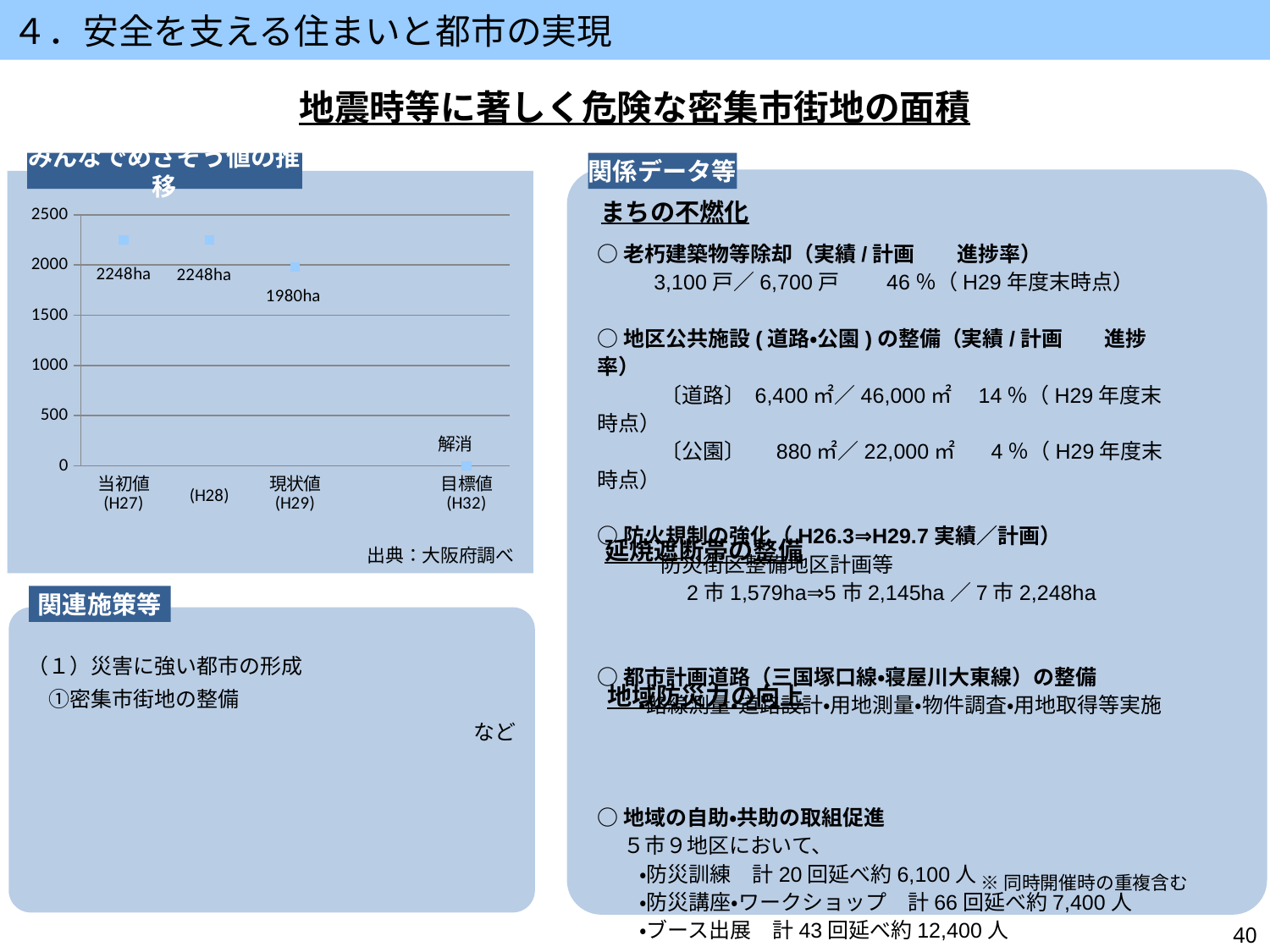
What is the value for 現状値 (H29)? 1980ha Is the value for 現状値 (H29) greater or less than 1500? greater How many categories are shown on the x axis? 4 What is the value for 当初値 (H27)? 2248ha What is the difference between the values for (H28) and 現状値 (H29)? 268ha Do the values rise or fall from 当初値 (H27) to 目標値 (H32)? fall Which category has the lowest value? 目標値 (H32) Which is larger, the value for 当初値 (H27) or 現状値 (H29)? 当初値 (H27) What source is cited below the chart? 大阪府調べ What is the title of the chart? みんなでめざそう値の推移 What is the value for (H28)? 2248ha What label is shown for the 目標値 (H32) point? 解消